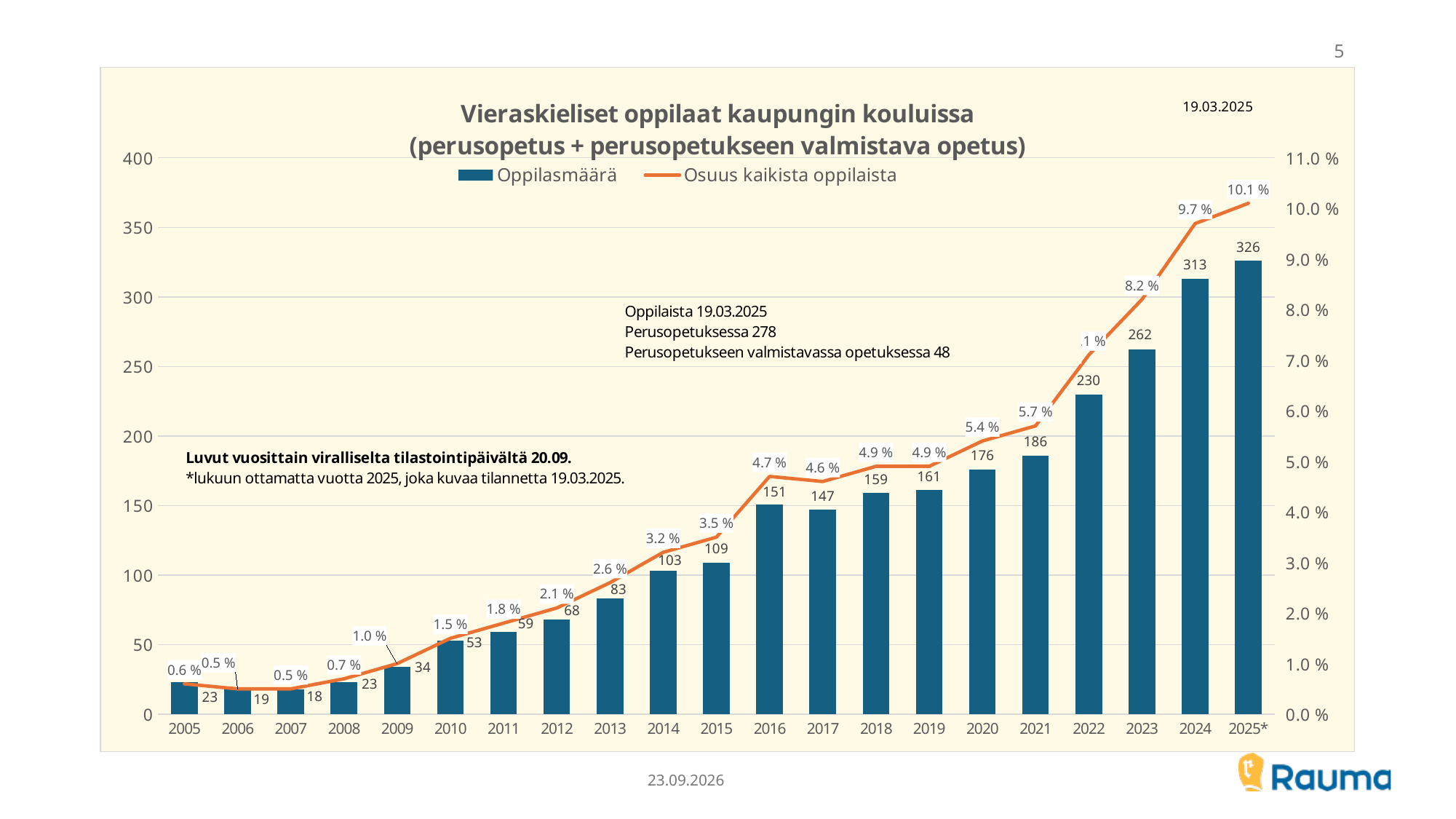
Does the Oppilasmäärä value generally rise or fall from 2007 to 2025*? Rise What is the Oppilasmäärä value for 2024? 313 What is the Osuus kaikista oppilaista value for 2016? 4.7 % What colour is the Osuus kaikista oppilaista line? Orange How many years are shown on the x axis? 21 What is the difference in Oppilasmäärä between 2025* and 2024? 13 Which year has the lowest Oppilasmäärä value? 2007 How many series does the legend list? 2 What is the Oppilasmäärä value for 2009? 34 Which year has the highest Osuus kaikista oppilaista value? 2025* Which year has the larger Oppilasmäärä value, 2016 or 2017? 2016 What kind of chart is this? Combined bar and line chart